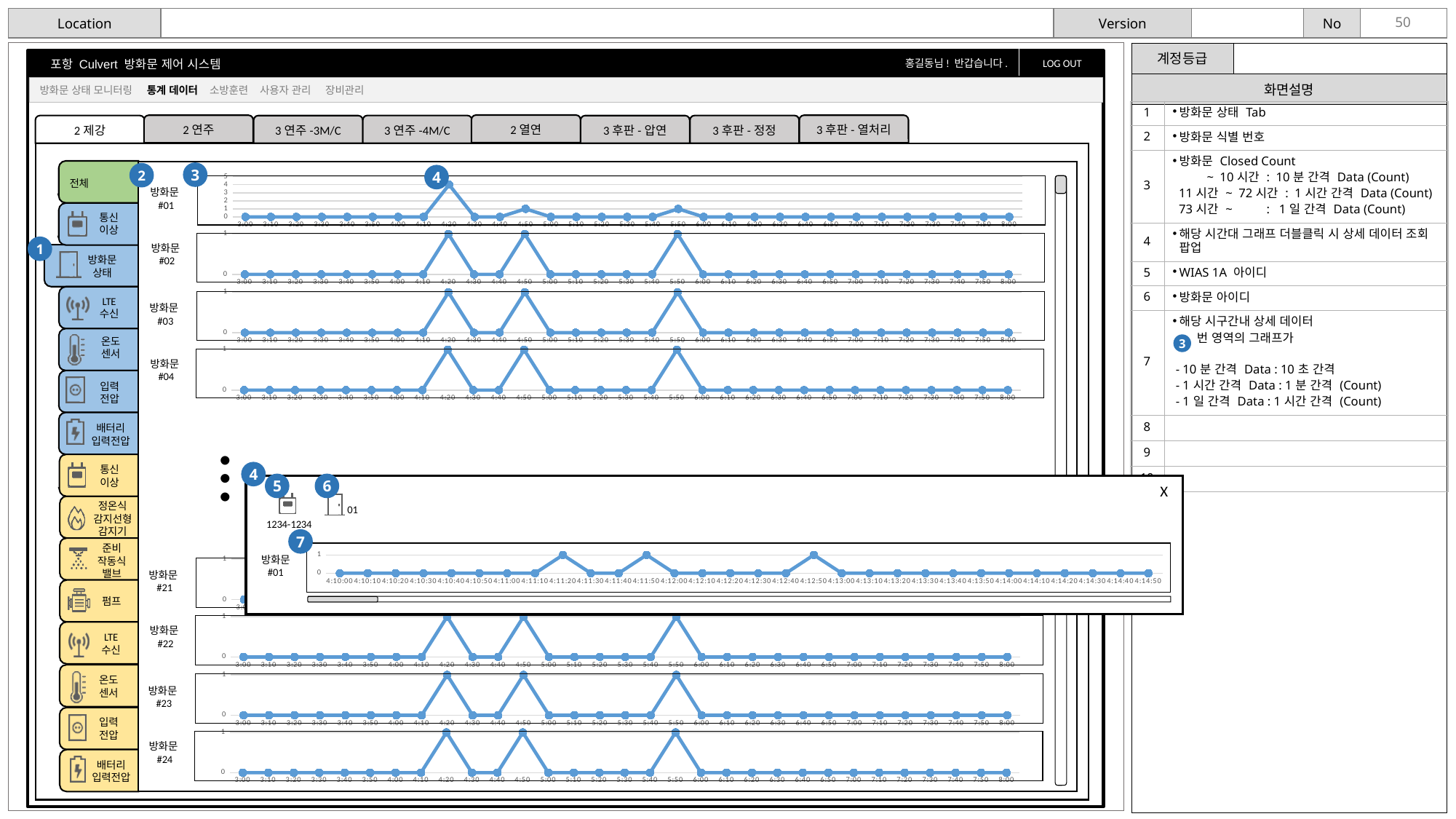
What kind of chart is used for 방화문 #02? line chart In the 방화문 #22 chart, what is the value at 5:50? 1 In the 방화문 #01 chart, which is larger, the value at 4:20 or the value at 4:50? 4:20 In the 방화문 #01 chart, is the value at 4:20 greater or less than 3? greater In the 방화문 #02 chart, what is the value at 4:20? 1 In the 방화문 #04 chart, how many points reach the value 1? 3 What is the last x-axis label on the 방화문 #02 chart? 8:00 In the 방화문 #24 chart, what is the value at 4:50? 1 In the 방화문 #03 chart, what is the value at 3:00? 0 In the 방화문 #01 chart, at which time is the value highest? 4:20 What is the first x-axis label on the 방화문 #02 chart? 3:00 In the 방화문 #23 chart, what is the value at 6:00? 0